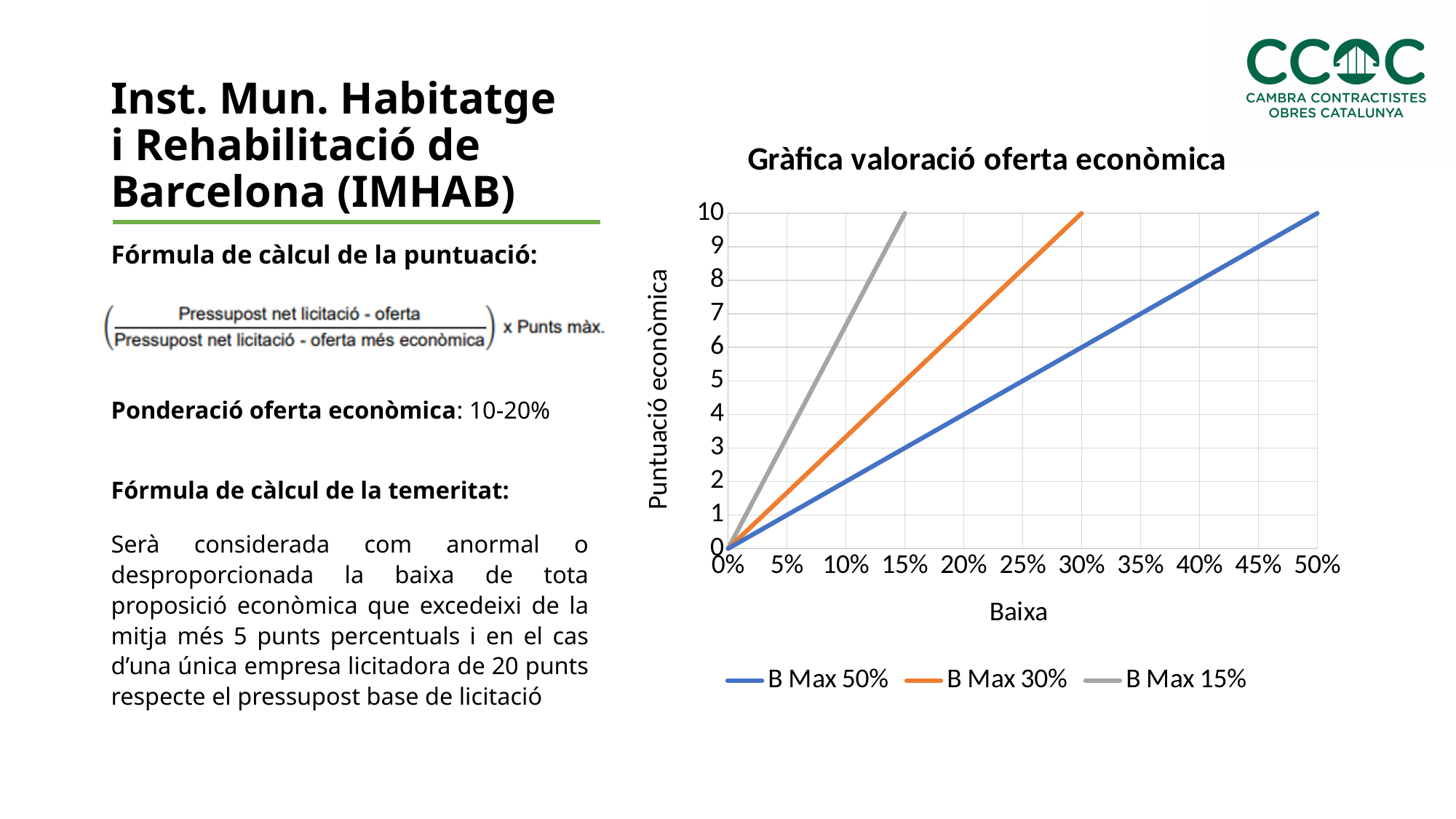
Is the Puntuació econòmica for B Max 15% at a Baixa of 10% greater or less than 6? greater What Puntuació econòmica does the B Max 50% line give at a Baixa of 25%? 5 At what value of Baixa does the B Max 50% line reach a Puntuació econòmica of 10? 50% Do the lines rise or fall as Baixa increases along the x axis? rise At a Baixa of 10%, which series gives the highest Puntuació econòmica? B Max 15% Is the Puntuació econòmica for B Max 30% at a Baixa of 10% greater or less than 4? less How many series does the chart legend list? 3 What is the label of the x axis of the chart? Baixa What is the title of the chart? Gràfica valoració oferta econòmica At what value of Baixa does the B Max 15% line reach a Puntuació econòmica of 10? 15% What type of chart is shown on the slide? line chart At what value of Baixa does the B Max 30% line reach a Puntuació econòmica of 10? 30%